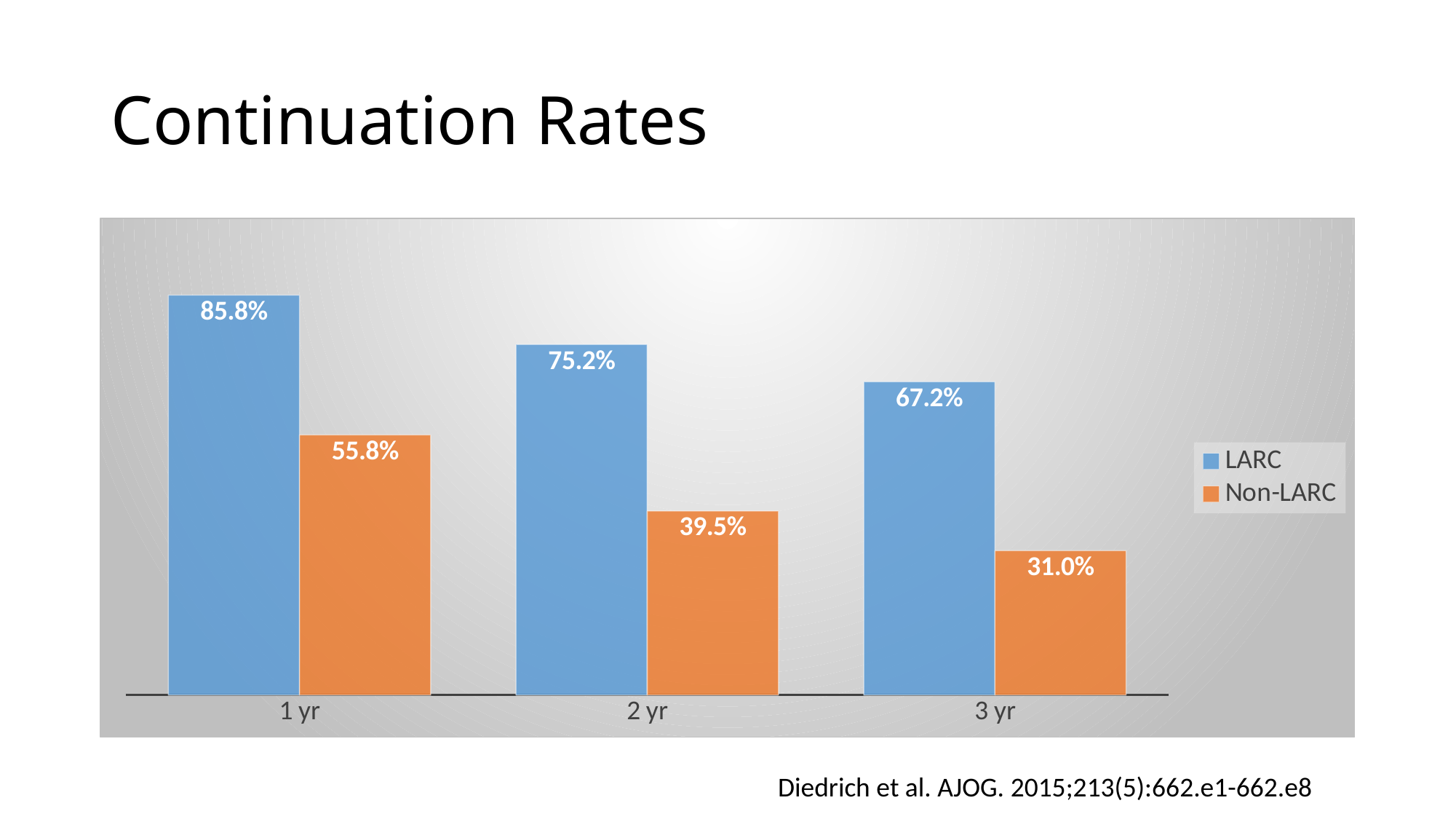
Do the LARC continuation rates rise or fall from 1 yr to 3 yr? fall What is the difference between the LARC and Non-LARC continuation rates at 1 yr? 30.0% How many time points are shown on the x axis? 3 How many series does the legend list? 2 What is the Non-LARC continuation rate at 2 yr? 39.5% What is the LARC continuation rate at 3 yr? 67.2% Which is larger at 3 yr, the LARC or the Non-LARC continuation rate? LARC What is the Non-LARC continuation rate at 3 yr? 31.0% What is the difference between the LARC and Non-LARC continuation rates at 2 yr? 35.7% What is the LARC continuation rate at 1 yr? 85.8% At which time point is the Non-LARC continuation rate lowest? 3 yr At which time point is the LARC continuation rate highest? 1 yr